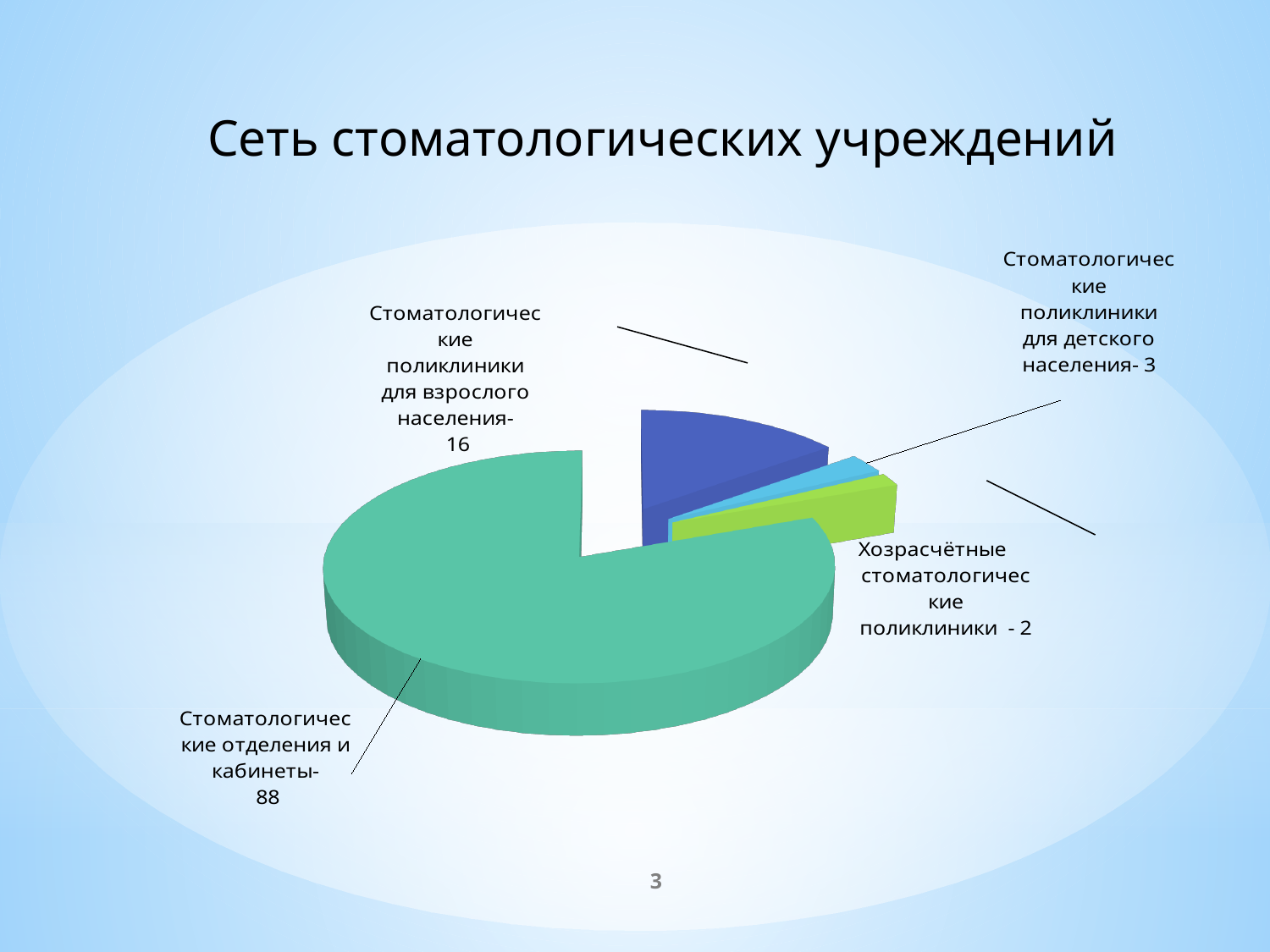
Which category has the largest slice of the pie? Стоматологические отделения и кабинеты Which category has the smallest slice of the pie? Хозрасчётные стоматологические поликлиники What is the difference between the value for Стоматологические отделения и кабинеты and the value for Стоматологические поликлиники для взрослого населения? 72 What type of chart is shown on the slide? Pie chart What is the title of the chart? Сеть стоматологических учреждений What is the value for Стоматологические поликлиники для детского населения? 3 Which is larger: the value for Стоматологические поликлиники для детского населения or the value for Хозрасчётные стоматологические поликлиники? Стоматологические поликлиники для детского населения How many categories (slices) does the pie chart have? 4 What is the total of all four values shown in the pie chart? 109 What is the value for Хозрасчётные стоматологические поликлиники? 2 What is the value for Стоматологические отделения и кабинеты? 88 What is the value for Стоматологические поликлиники для взрослого населения? 16